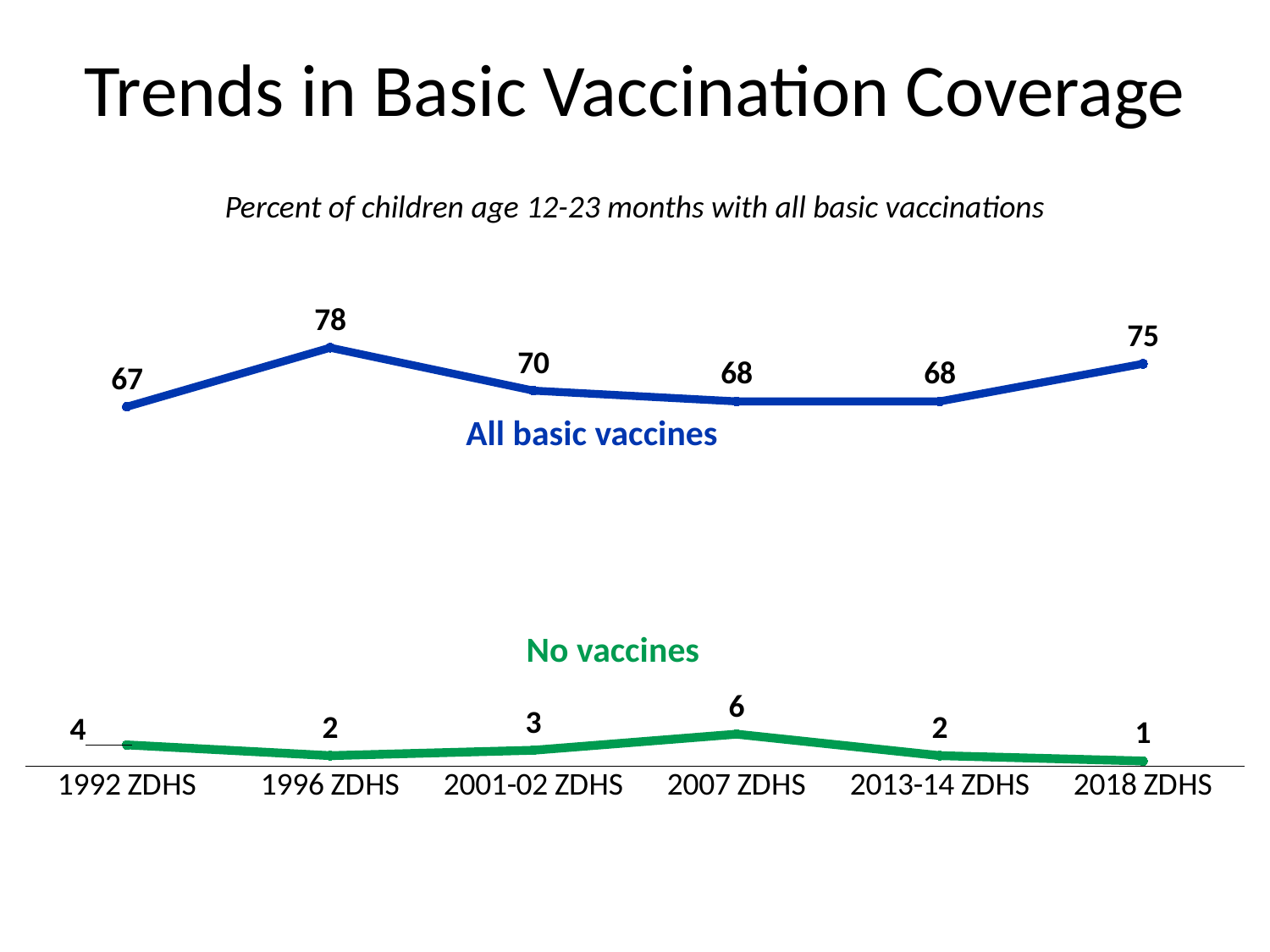
How many surveys are shown on the x axis? 6 What is the value for All basic vaccines in the 2018 ZDHS? 75 What is the value for All basic vaccines in the 1996 ZDHS? 78 What is the difference between the All basic vaccines values in the 1996 ZDHS and the 1992 ZDHS? 11 What is the value for No vaccines in the 2007 ZDHS? 6 Which is larger, the All basic vaccines value in the 2001-02 ZDHS or in the 2018 ZDHS? 2018 ZDHS In which survey is the All basic vaccines value highest? 1996 ZDHS How many series are plotted on the chart? 2 What kind of chart is shown on the slide? Line chart What colour is the No vaccines line? Green Did the No vaccines value rise or fall from the 2007 ZDHS to the 2018 ZDHS? Fall In which survey is the No vaccines value lowest? 2018 ZDHS